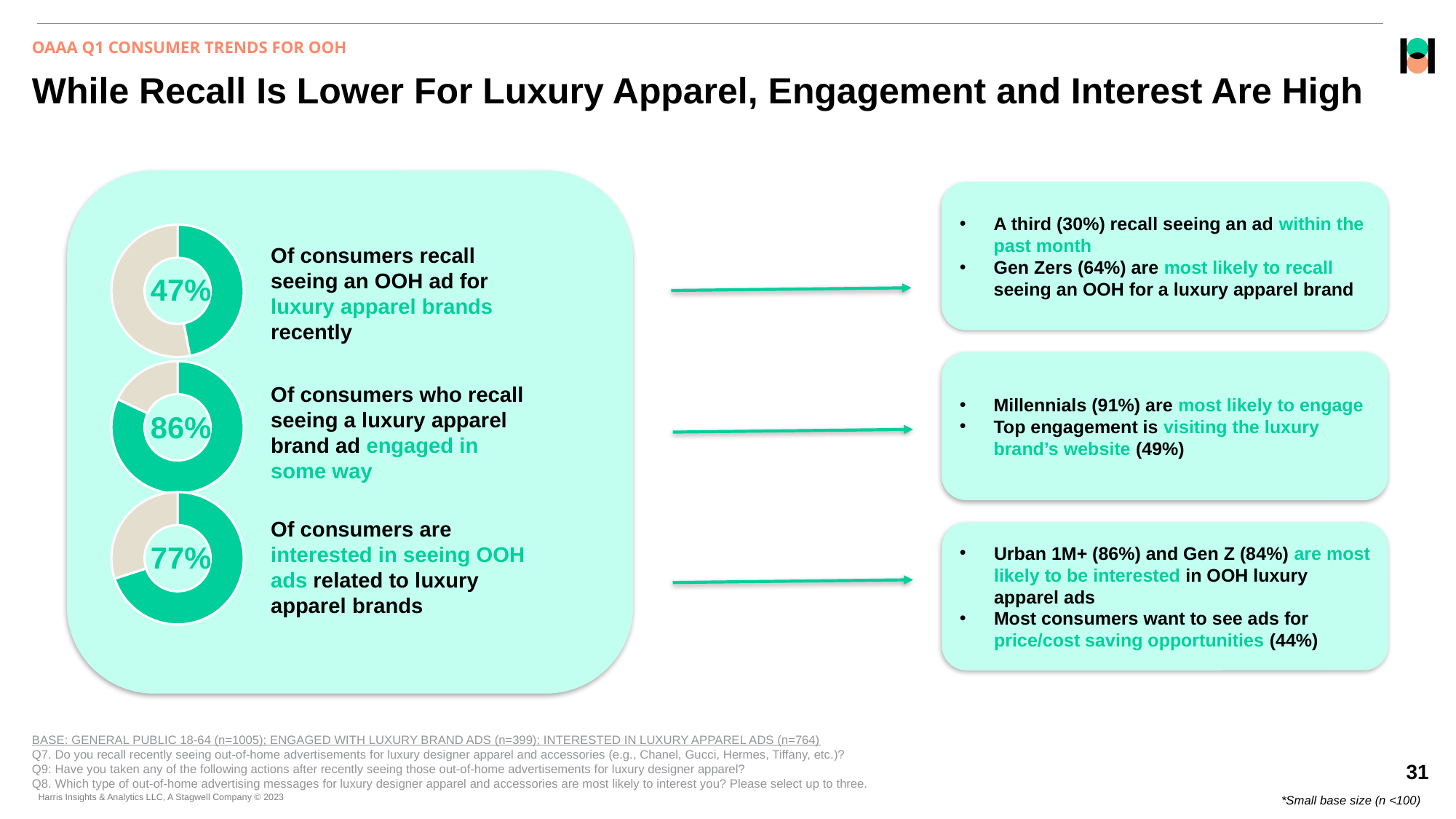
On the bottom donut chart, what percentage of consumers are interested in seeing OOH ads related to luxury apparel brands? 77% What is the difference between the interest percentage (bottom chart) and the recall percentage (top chart)? 30 percentage points What colour is used for the filled (highlighted) portion of each donut chart? Green Which of the three donut charts shows the lowest percentage? The top chart (recall seeing an OOH ad), 47% What is the difference between the engagement percentage (middle chart) and the recall percentage (top chart)? 39 percentage points How many donut charts are shown on the slide? 3 Which is larger: the percentage of consumers interested in seeing OOH luxury apparel ads (bottom chart) or the percentage who engaged in some way (middle chart)? Engaged in some way (86%) What kind of charts are used on the left side of the slide? Donut (pie) charts On the top donut chart, what percentage of consumers recall seeing an OOH ad for luxury apparel brands recently? 47% On the middle donut chart, what percentage of consumers who recall seeing a luxury apparel brand ad engaged in some way? 86% Is the value shown on the top donut chart greater or less than 50%? less Which of the three donut charts shows the highest percentage? The middle chart (engaged in some way), 86%